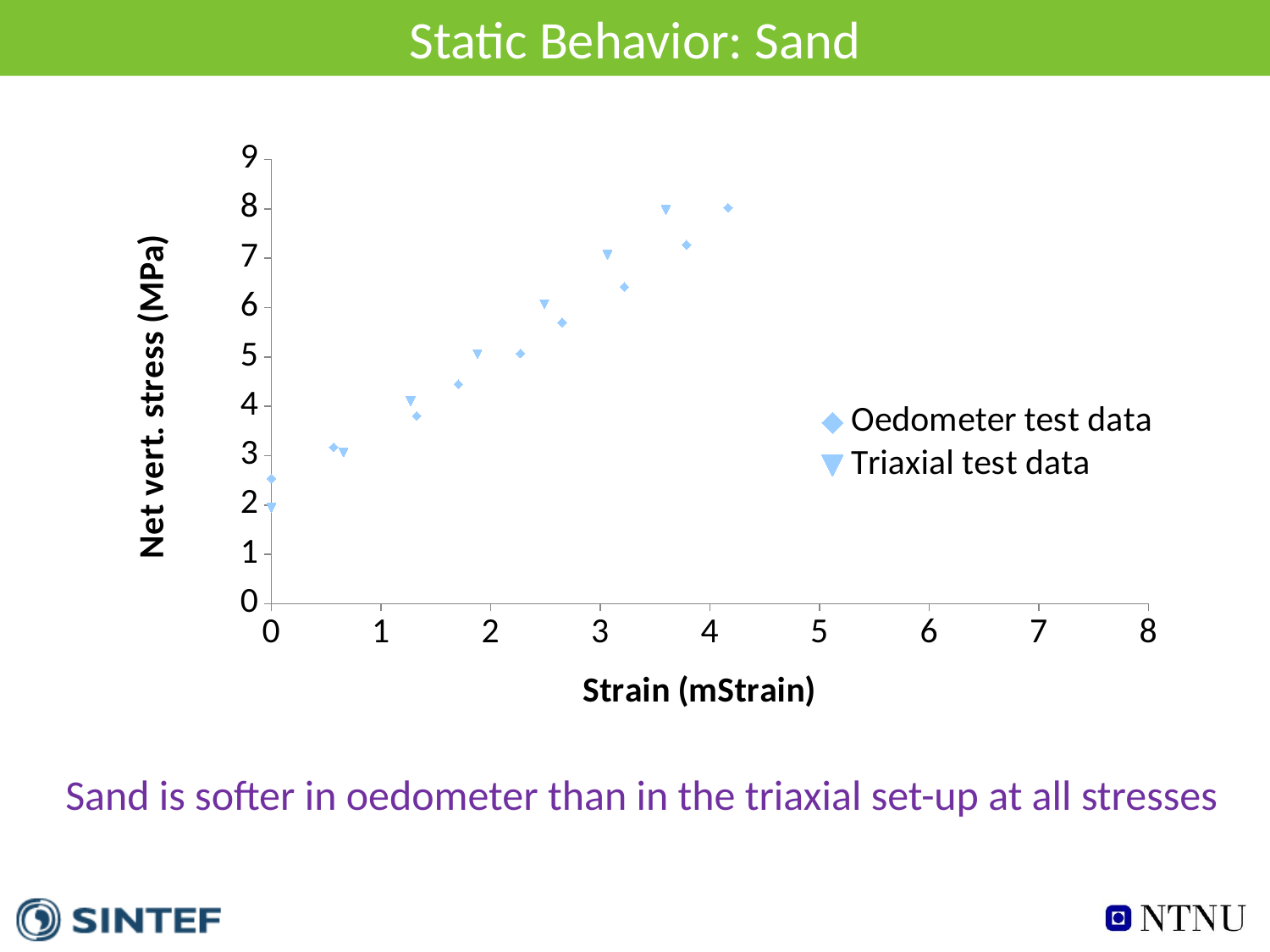
What kind of chart is shown on the slide? scatter chart Does the net vertical stress rise or fall as strain increases for the Oedometer test data? rise What is the label of the y axis? Net vert. stress (MPa) Does the net vertical stress rise or fall as strain increases for the Triaxial test data? rise Is the largest strain plotted for the Oedometer test data greater or less than 5 mStrain? less At a strain of 0, which series shows the higher net vertical stress, Oedometer test data or Triaxial test data? Oedometer test data How many series does the legend list? 2 Is the highest net vertical stress plotted for either series greater or less than 9 MPa? less What are the two series named in the legend? Oedometer test data and Triaxial test data Is the largest strain reached by the Triaxial test data greater or less than 4 mStrain? less Which series reaches a net vertical stress of about 8 MPa at the lower strain, Oedometer test data or Triaxial test data? Triaxial test data